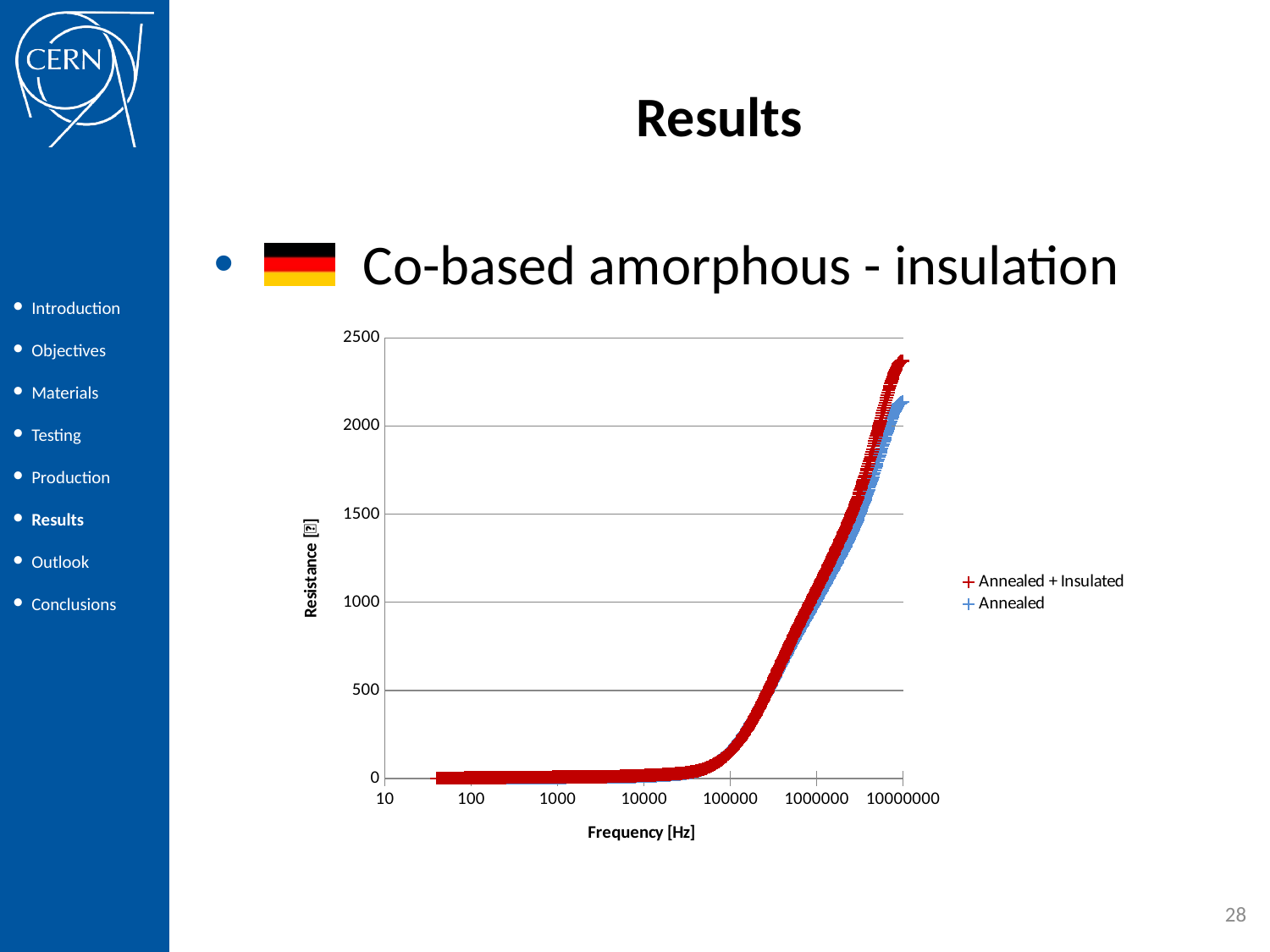
Is the resistance of the Annealed + Insulated series at 100000 Hz greater or less than 500? less Is the resistance of the Annealed + Insulated series at 10000000 Hz greater or less than 2000? greater Does the resistance rise or fall as frequency increases along the x axis? rise What is the label of the x axis of the chart? Frequency [Hz] What are the two series named in the chart legend? Annealed + Insulated; Annealed Is the resistance of the Annealed series at 1000 Hz greater or less than 500? less At 10000000 Hz, which series has the higher resistance, Annealed + Insulated or Annealed? Annealed + Insulated How many series does the chart legend list? 2 What type of chart is shown on the slide? scatter chart What is the highest value shown on the y axis of the chart? 2500